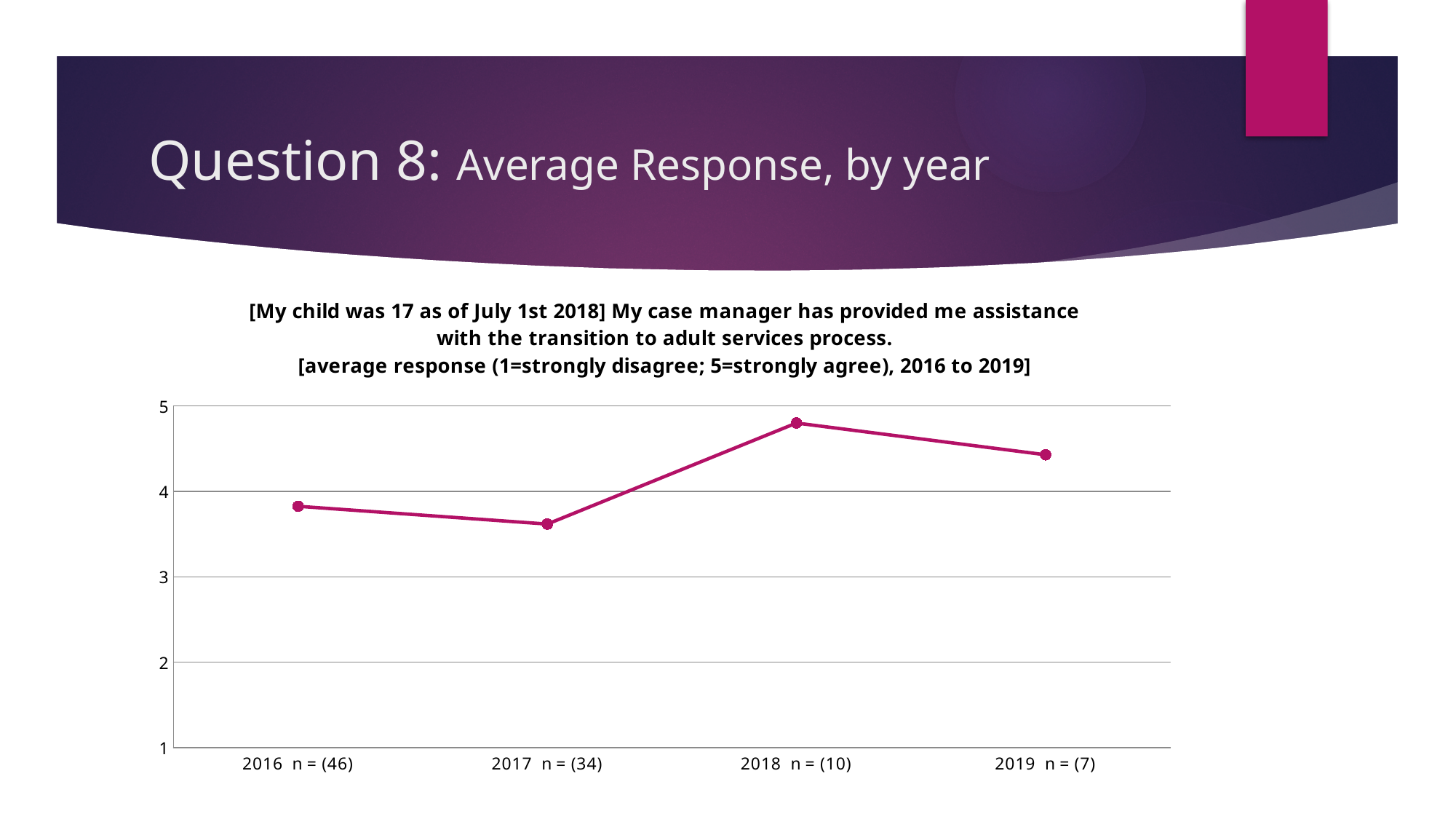
Which year has the larger average response, 2018 or 2019? 2018 What is the sample size (n) shown for 2016 on the x axis? 46 Is the average response for 2018 greater or less than 4? greater Does the average response rise or fall from 2017 to 2018? rise Which year has the lowest average response? 2017 What kind of chart is shown on the slide? line chart Is the average response for 2019 greater or less than 4? greater Is the average response for 2016 greater or less than 4? less Does the average response rise or fall from 2018 to 2019? fall How many data points are plotted on the line? 4 Which year has the highest average response? 2018